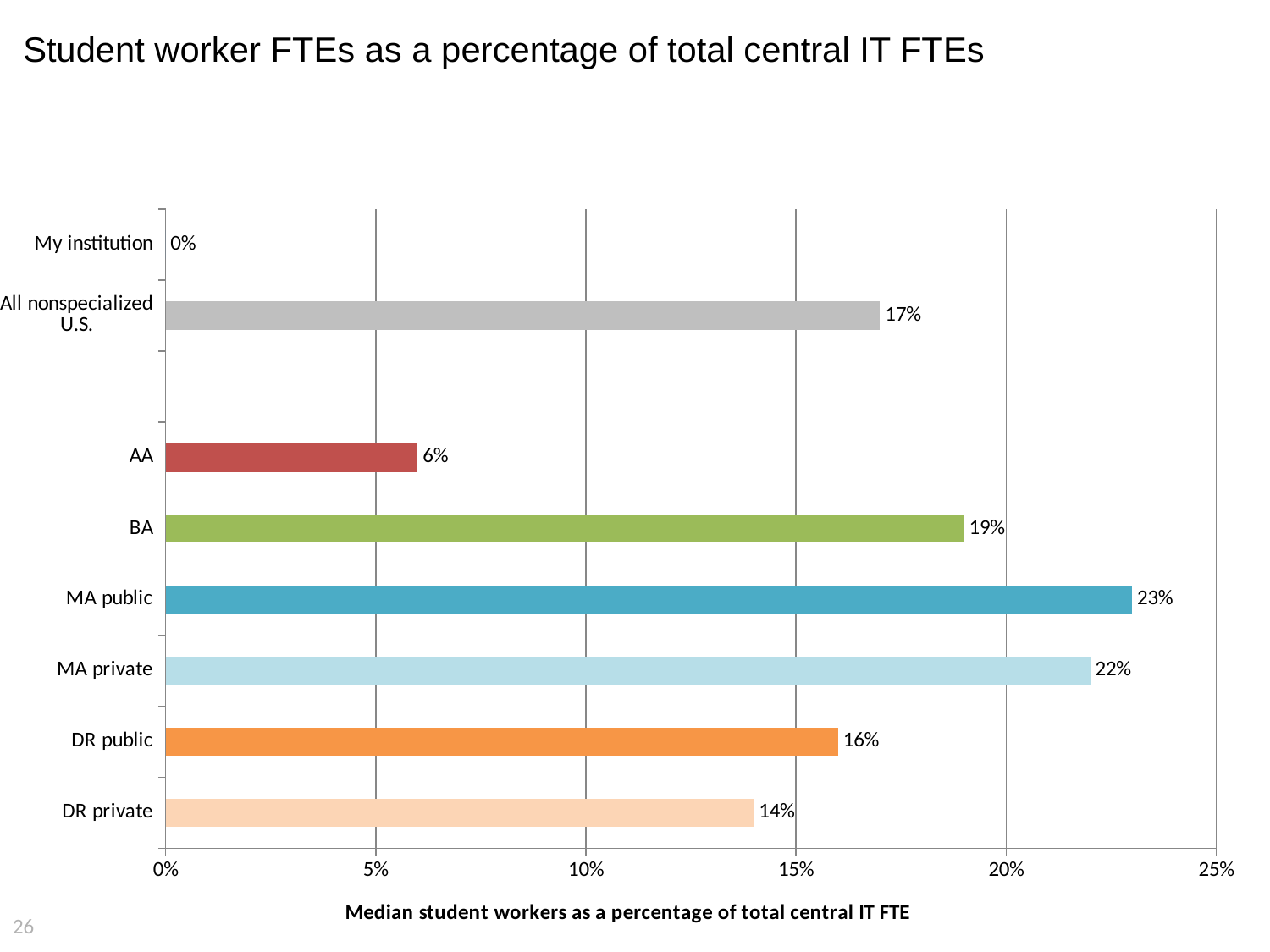
Which category has the highest value? MA public What is the value for MA public? 23% What is the value for My institution? 0% What is the difference between the values for BA and AA? 13% Which is larger, the value for DR public or the value for DR private? DR public What kind of chart is shown on the slide? bar chart How many categories are shown on the chart? 8 Is the value for MA private greater or less than 20%? greater What is the x-axis title of the chart? Median student workers as a percentage of total central IT FTE Which category has the lowest value, excluding My institution? AA What is the value for DR private? 14% What is the value for All nonspecialized U.S.? 17%